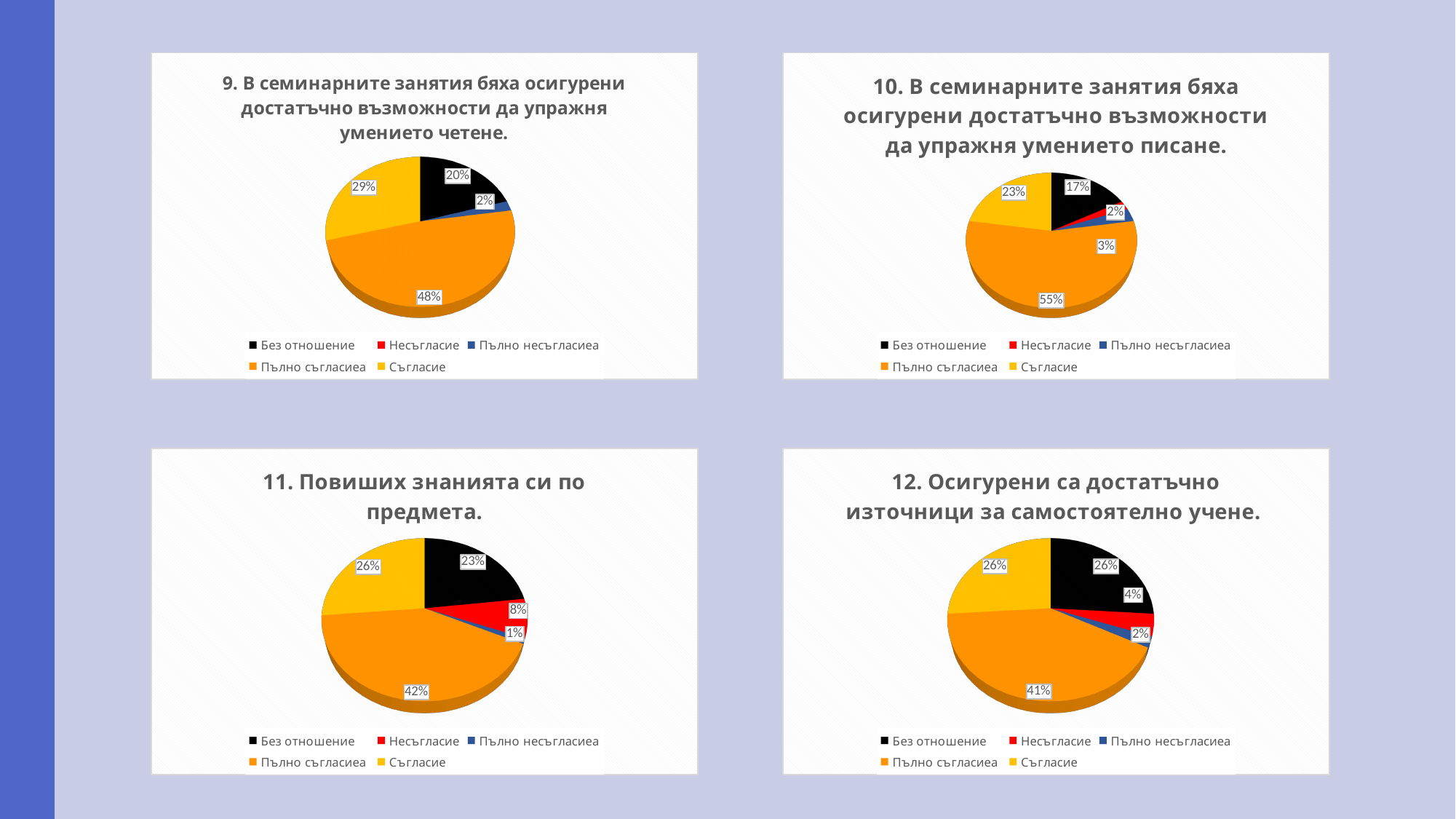
In the chart titled "9. В семинарните занятия бяха осигурени достатъчно възможности да упражня умението четене.", what percentage is shown for Пълно съгласиеа? 48% In the bottom-left chart (question 11), which is larger: Без отношение or Съгласие? Съгласие In the top-left chart (question 9), which category has the largest slice? Пълно съгласиеа In the chart titled "11. Повиших знанията си по предмета.", what percentage is shown for Несъгласие? 8% In the chart titled "9. В семинарните занятия бяха осигурени достатъчно възможности да упражня умението четене.", what percentage is shown for Без отношение? 20% In the chart titled "10. В семинарните занятия бяха осигурени достатъчно възможности да упражня умението писане.", what percentage is shown for Пълно съгласиеа? 55% In the bottom-right chart (question 12), what is the difference between the Несъгласие share and the Пълно несъгласиеа share? 2% In the chart titled "12. Осигурени са достатъчно източници за самостоятелно учене.", what percentage is shown for Пълно съгласиеа? 41% In the top-right chart (question 10), what is the difference between the Пълно съгласиеа share and the Без отношение share? 38% What type of chart is used for question 12 (bottom-right)? Pie chart In the top-right chart (question 10), what percentage is shown for Съгласие? 23% In the bottom-left chart (question 11), which category has the smallest slice? Пълно несъгласиеа